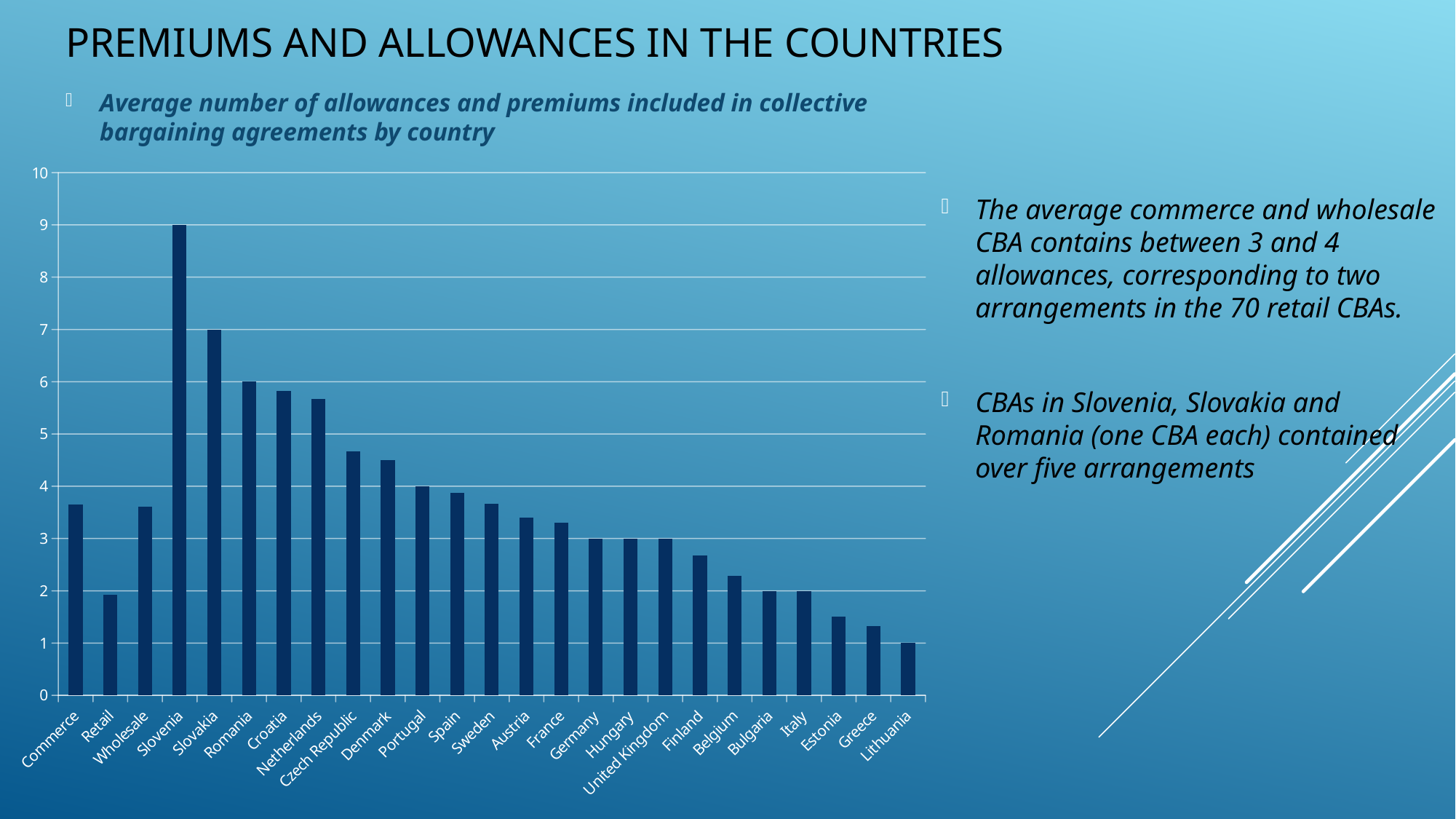
What is the difference between the values for Slovenia and Slovakia? 2 Which is larger, the value for Slovakia or the value for Romania? Slovakia Which category has the highest average number of allowances and premiums? Slovenia What is the value for Slovakia? 7 What is the value for Slovenia? 9 Which category has the lowest average number of allowances and premiums? Lithuania What kind of chart is shown on the slide? bar chart What is the value for Lithuania? 1 How many categories are shown on the x axis of the chart? 25 What is the value for Romania? 6 Is the value for Croatia greater or less than 5? greater